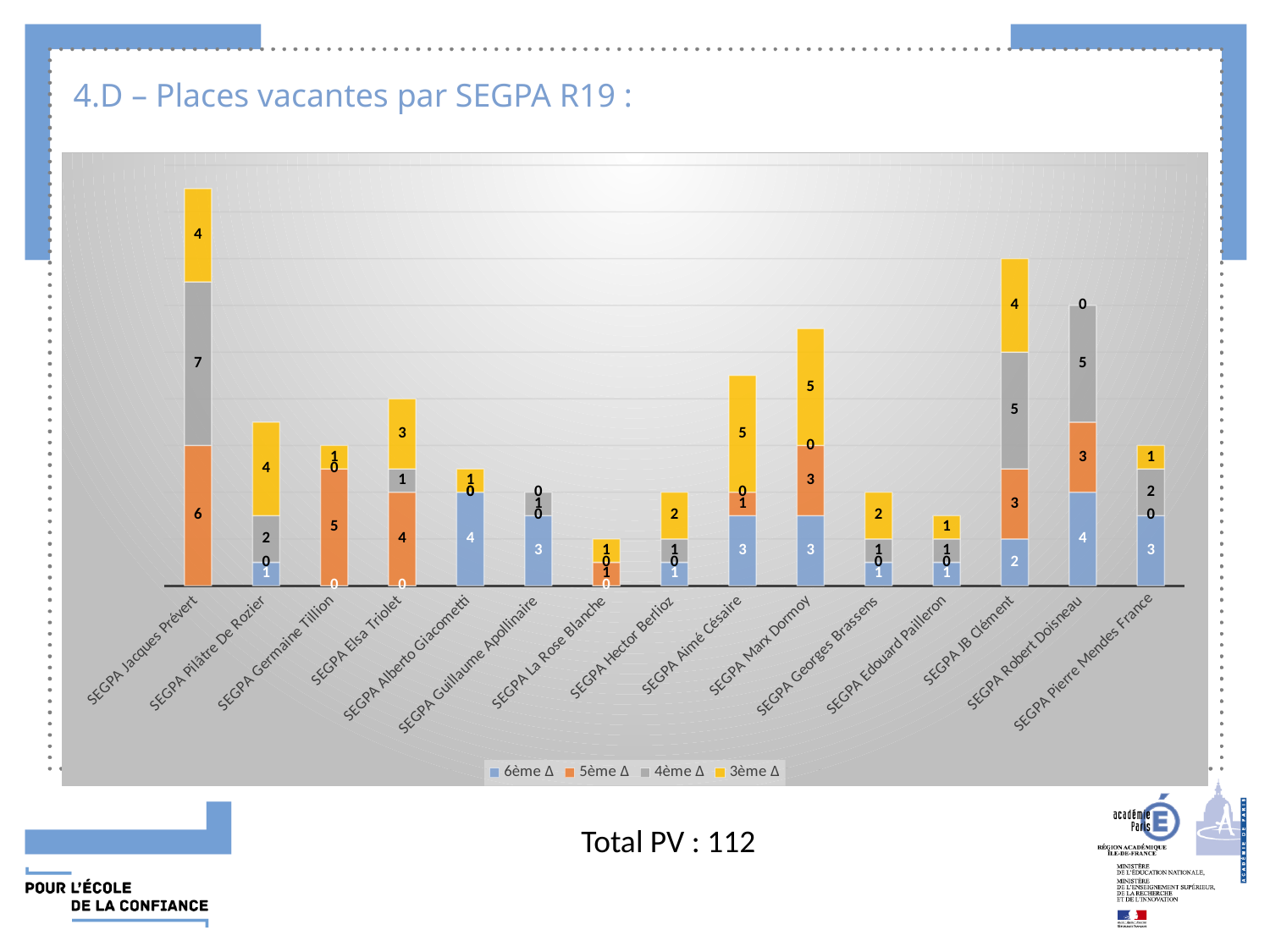
What is the 3ème Δ value for SEGPA Marx Dormoy? 5 What is the 6ème Δ value for SEGPA Robert Doisneau? 4 Which has the larger 5ème Δ value, SEGPA Jacques Prévert or SEGPA Germaine Tillion? SEGPA Jacques Prévert How many series does the legend list? 4 What is the total of the stacked bar for SEGPA JB Clément? 14 What is the total of the stacked bar for SEGPA Marx Dormoy? 11 Which SEGPA has the tallest stacked bar? SEGPA Jacques Prévert What is the difference between the 4ème Δ values of SEGPA JB Clément and SEGPA Pierre Mendes France? 3 Which SEGPA has the shortest stacked bar? SEGPA La Rose Blanche What kind of chart is shown on the slide? Stacked bar chart What is the 4ème Δ value for SEGPA Jacques Prévert? 7 How many SEGPA categories are shown on the x axis? 15